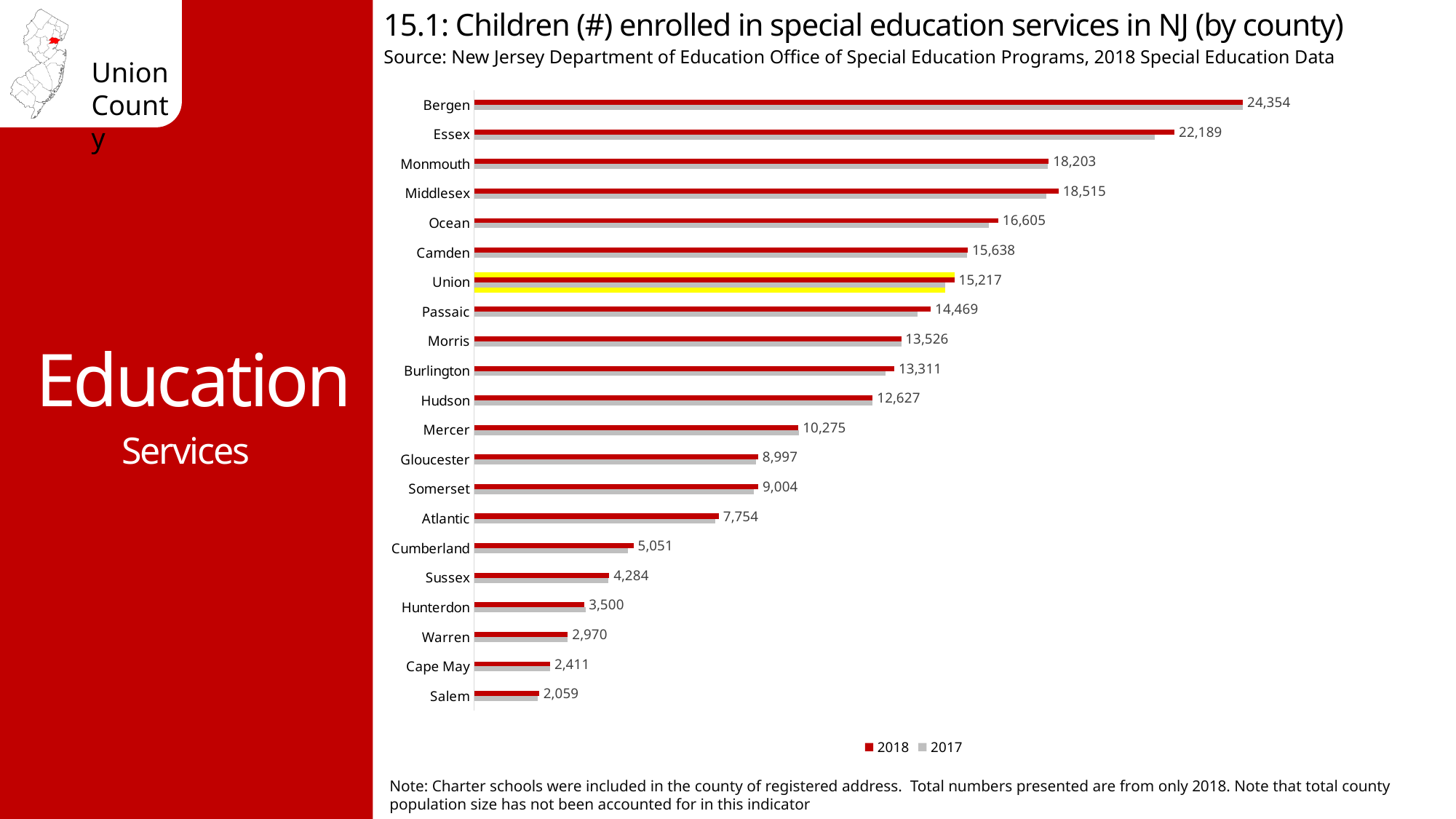
Which county has the lowest number of children enrolled in special education services in 2018? Salem How many children were enrolled in special education services in Bergen County in 2018? 24,354 What is the 2018 value shown for Salem County? 2,059 How many counties are shown in the chart? 21 Which county had more children enrolled in 2018, Somerset or Gloucester? Somerset What type of chart is shown on the slide? Bar chart What is the 2018 value shown for Union County? 15,217 Which county had more children enrolled in 2018, Middlesex or Monmouth? Middlesex What is the difference between the 2018 values for Bergen and Essex? 2,165 How many series does the legend list? 2 Which county has the highest number of children enrolled in special education services in 2018? Bergen What is the difference between the 2018 values for Union and Passaic? 748